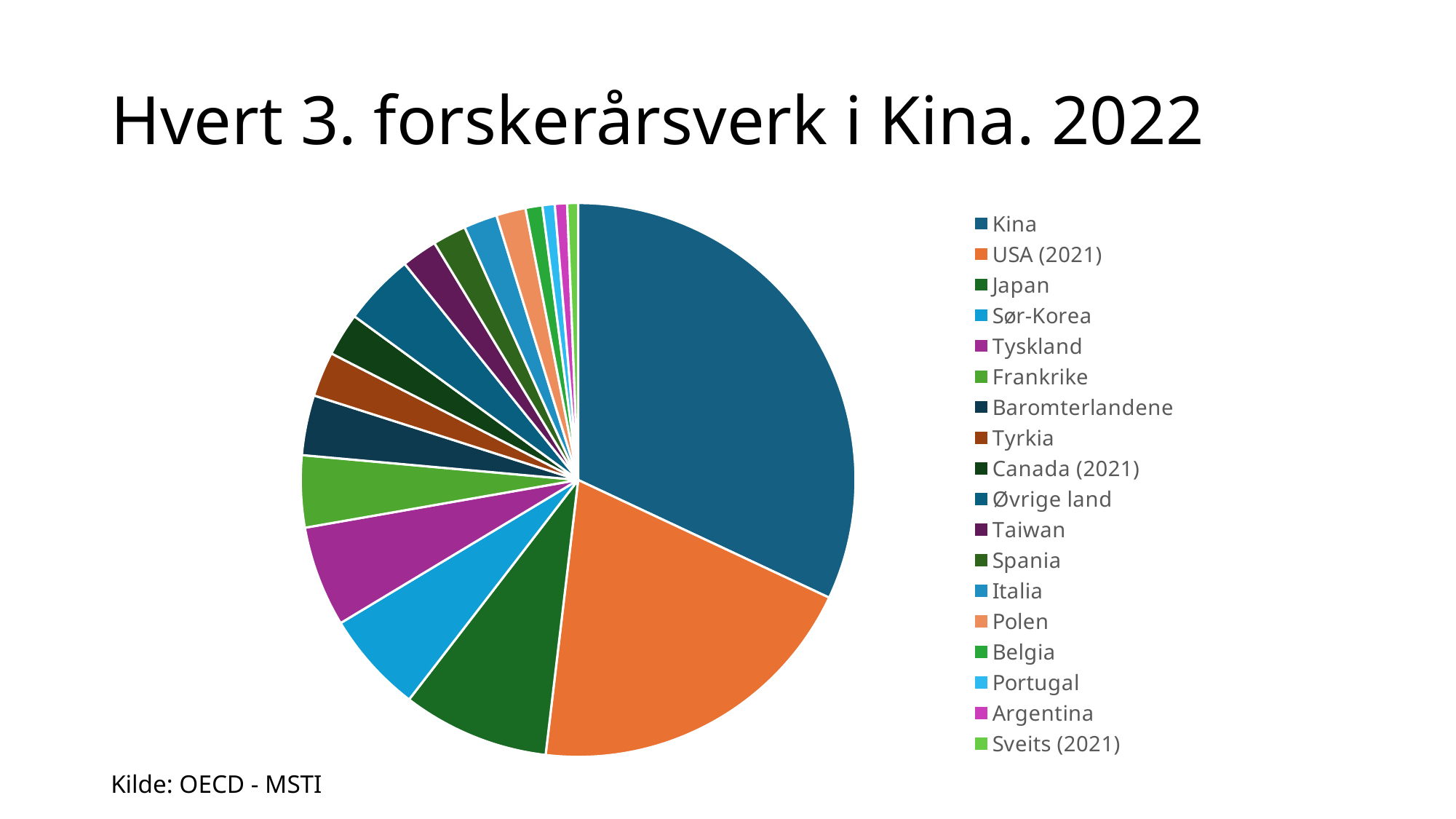
Which category has the second-largest slice of the pie? USA (2021) Which slice is larger, USA (2021) or Japan? USA (2021) Which slice is larger, Tyskland or Frankrike? Tyskland What is the title of the chart? Hvert 3. forskerårsverk i Kina. 2022 Which category has the largest slice of the pie? Kina Which slice is larger, Japan or Sør-Korea? Japan How many slices does the pie chart have? 18 What kind of chart is shown on the slide? pie chart What source is cited for the chart? OECD - MSTI